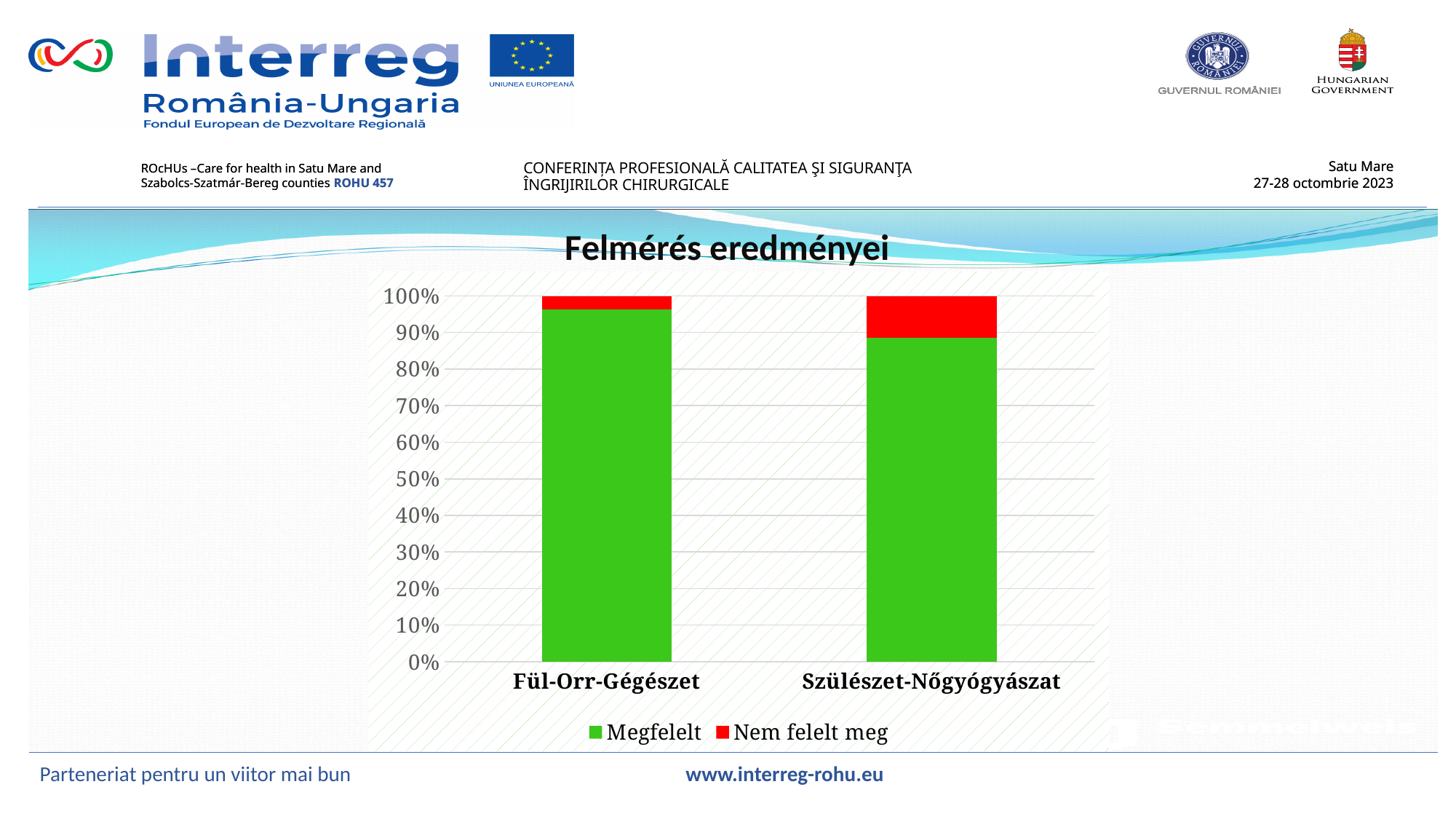
Is the Nem felelt meg value for Szülészet-Nőgyógyászat greater or less than 20%? less What is the title of the chart? Felmérés eredményei Which series is shown in red in the chart? Nem felelt meg Which category has the higher Megfelelt share, Fül-Orr-Gégészet or Szülészet-Nőgyógyászat? Fül-Orr-Gégészet How many categories are shown on the x axis of the chart? 2 Which category has the largest Nem felelt meg share? Szülészet-Nőgyógyászat How many series does the chart's legend list? 2 Is the Nem felelt meg value for Fül-Orr-Gégészet greater or less than 10%? less Is the Megfelelt value for Szülészet-Nőgyógyászat greater or less than 90%? less What kind of chart is shown on the slide? Stacked bar chart Which category has the smallest Megfelelt share? Szülészet-Nőgyógyászat